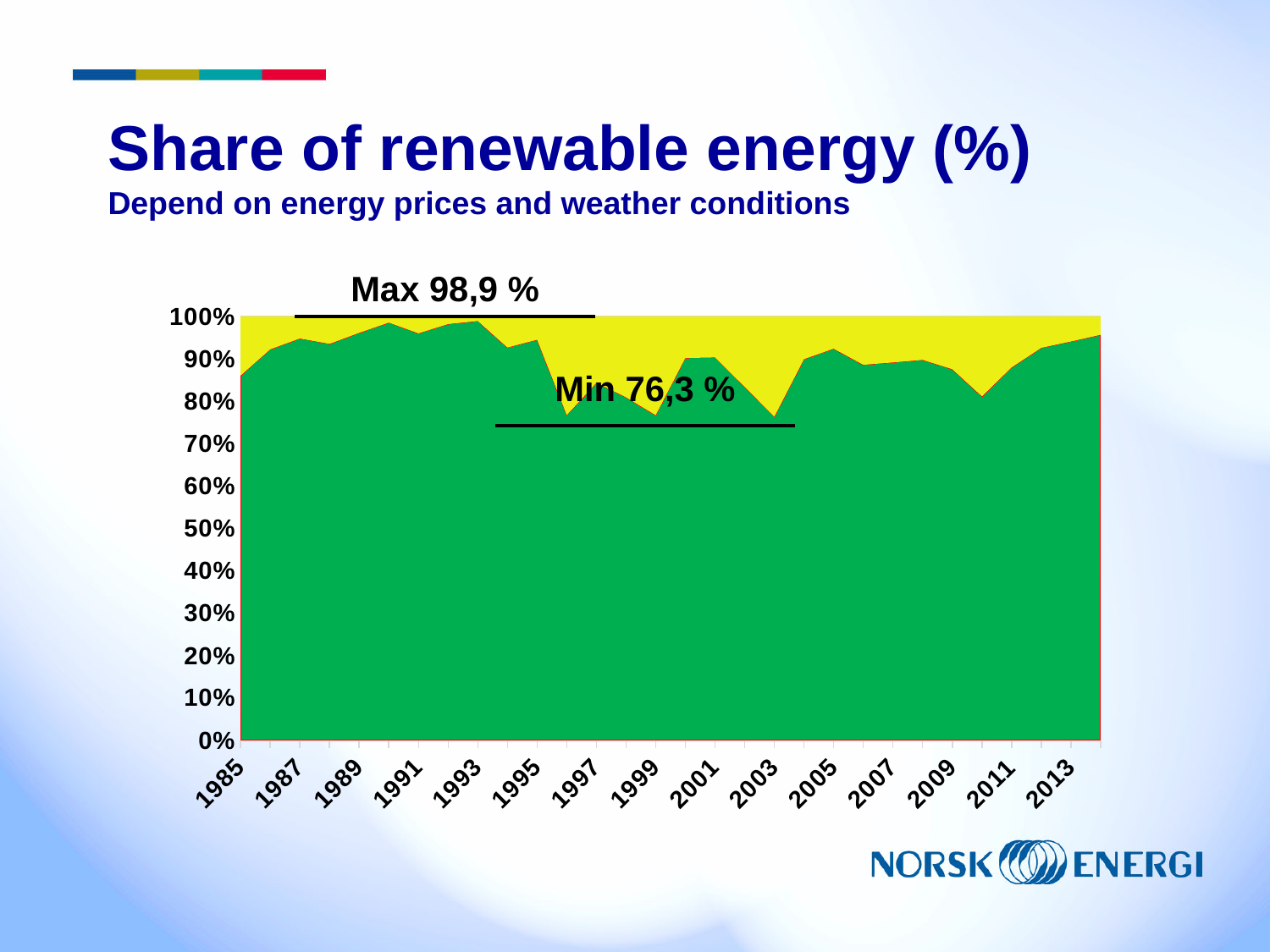
What is the maximum share of renewable energy annotated on the chart? 98,9 % What is the difference between the annotated maximum and minimum shares of renewable energy? 22,6 % Is the share of renewable energy in 2011 greater or less than 90%? less What is the minimum share of renewable energy annotated on the chart? 76,3 % What kind of chart is shown on the slide? area chart Is the share of renewable energy in 1985 greater or less than 90%? less Which year has the larger share of renewable energy, 1993 or 2003? 1993 How many year labels are shown on the x axis? 15 Does the share of renewable energy rise or fall from 1985 to 1993? rise Is the share of renewable energy in 1993 greater or less than 90%? greater What is the title of the chart on the slide? Share of renewable energy (%)